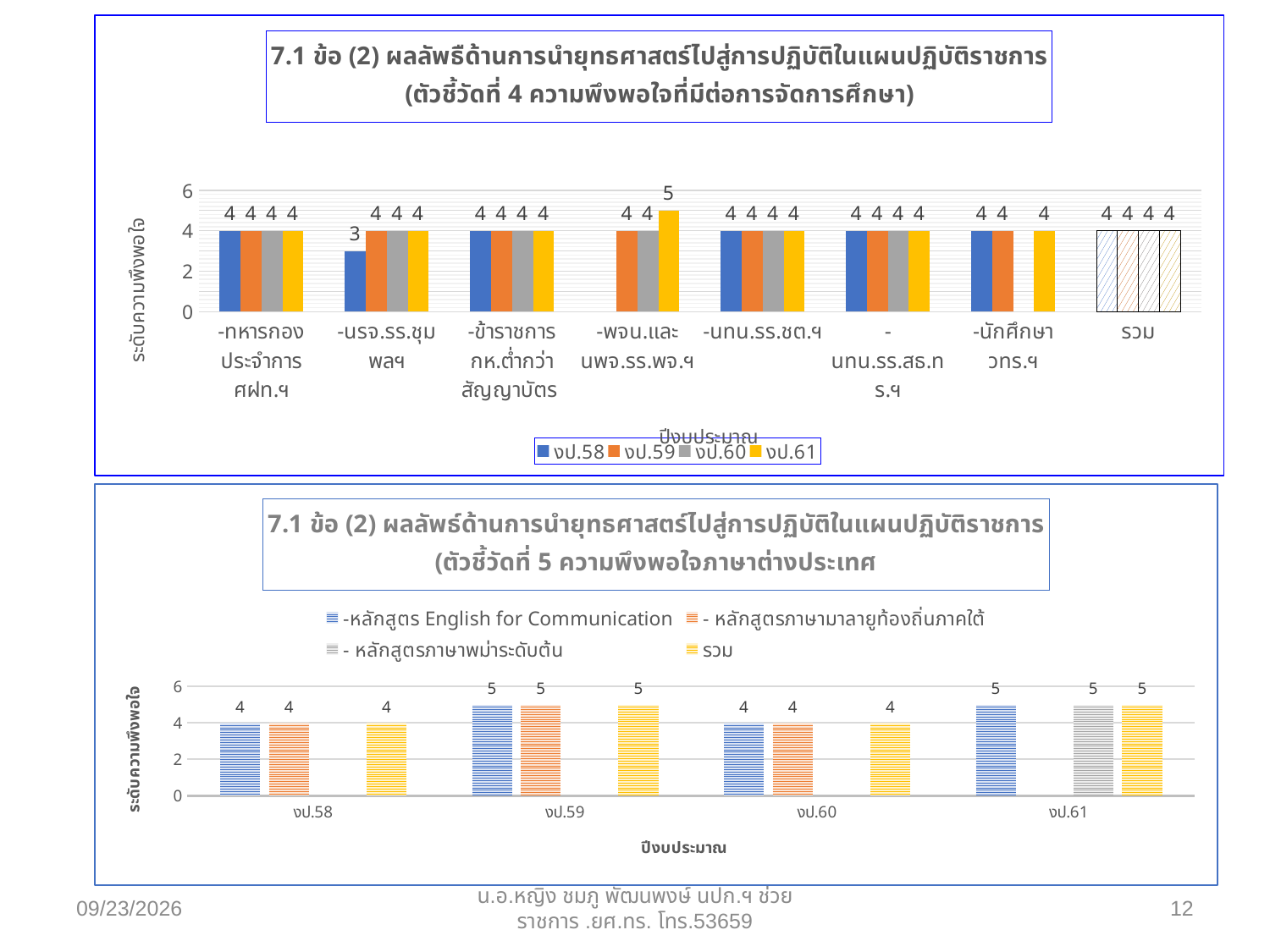
In the bottom chart (ตัวชี้วัดที่ 5), what is the value for หลักสูตรภาษาพม่าระดับต้น in งป.61? 5 In the bottom chart (ตัวชี้วัดที่ 5), what is the value for หลักสูตร English for Communication in งป.59? 5 In the top chart (ตัวชี้วัดที่ 4), which category has the lowest value in งป.58? นรจ.รร.ชุมพลฯ What kind of chart is the bottom chart (ตัวชี้วัดที่ 5)? bar chart In the bottom chart (ตัวชี้วัดที่ 5), how many series does the legend list? 4 In the top chart (ตัวชี้วัดที่ 4), what is the value for พจน.และ นพจ.รร.พจ.ฯ in งป.61? 5 In the top chart (ตัวชี้วัดที่ 4), how many series does the legend list? 4 In the top chart (ตัวชี้วัดที่ 4), what is the difference between the งป.61 value for พจน.และ นพจ.รร.พจ.ฯ and the งป.58 value for นรจ.รร.ชุมพลฯ? 2 In the bottom chart (ตัวชี้วัดที่ 5), is the รวม value for งป.59 larger or smaller than the รวม value for งป.60? larger In the top chart (ตัวชี้วัดที่ 4), what is the value for นรจ.รร.ชุมพลฯ in งป.58? 3 In the top chart (ตัวชี้วัดที่ 4), how many categories are shown on the x axis? 8 In the top chart (ตัวชี้วัดที่ 4), which category has the highest value in งป.61? พจน.และ นพจ.รร.พจ.ฯ